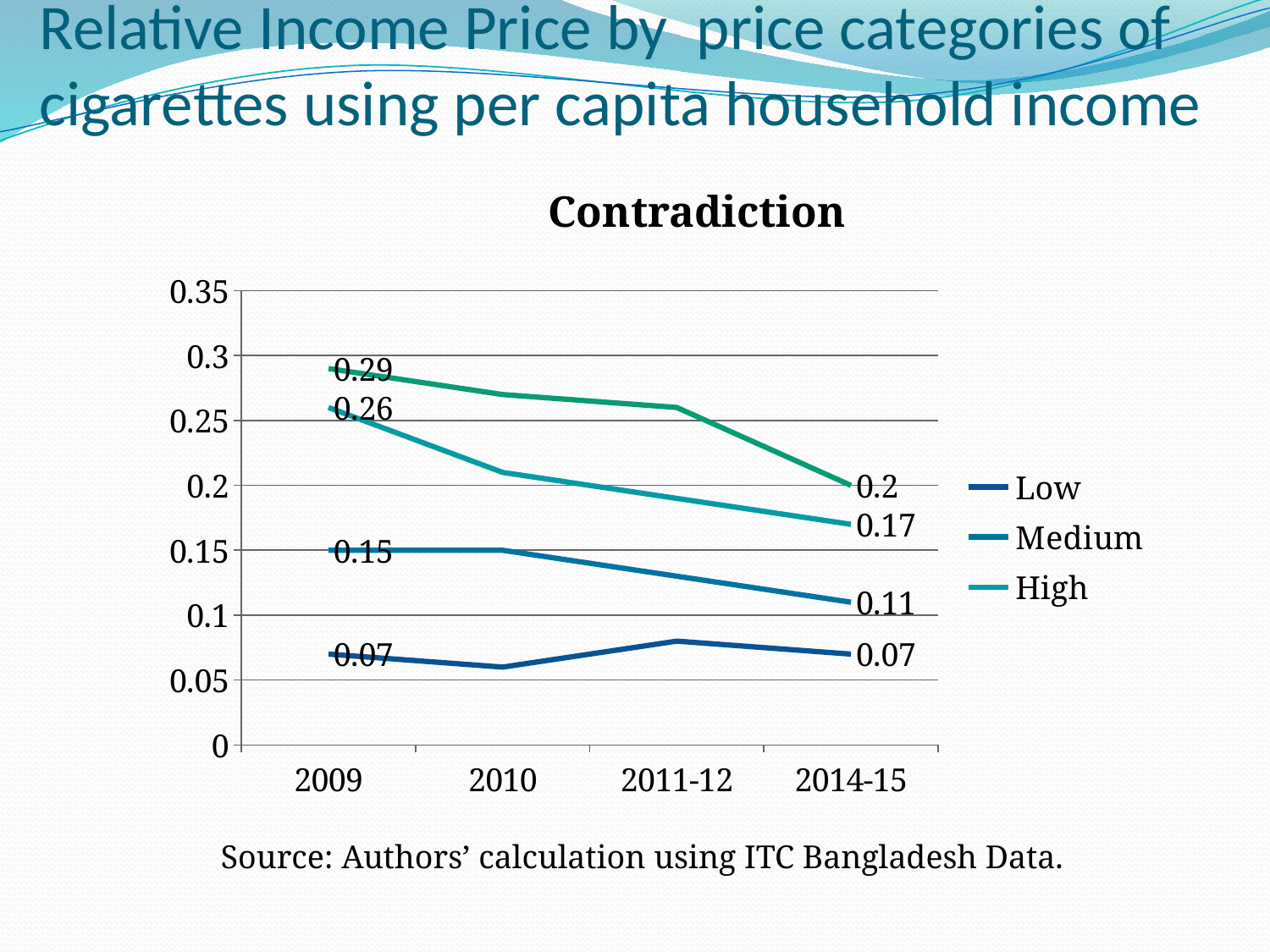
What is the title of the chart? Contradiction What is the value for the High series in 2009? 0.26 What kind of chart is shown on the slide? line chart What is the value for the Medium series in 2014-15? 0.11 What is the value for the Low series in 2009? 0.07 How many series does the legend list? 3 What is the value for the High series in 2014-15? 0.17 By how much did the High series fall from 2009 to 2014-15? 0.09 Which series has the larger value in 2014-15, High or Medium? High Is the value for the Medium series in 2011-12 greater or less than 0.15? less How many time periods are shown on the x axis? 4 By how much did the Medium series fall from 2009 (0.15) to 2014-15 (0.11)? 0.04